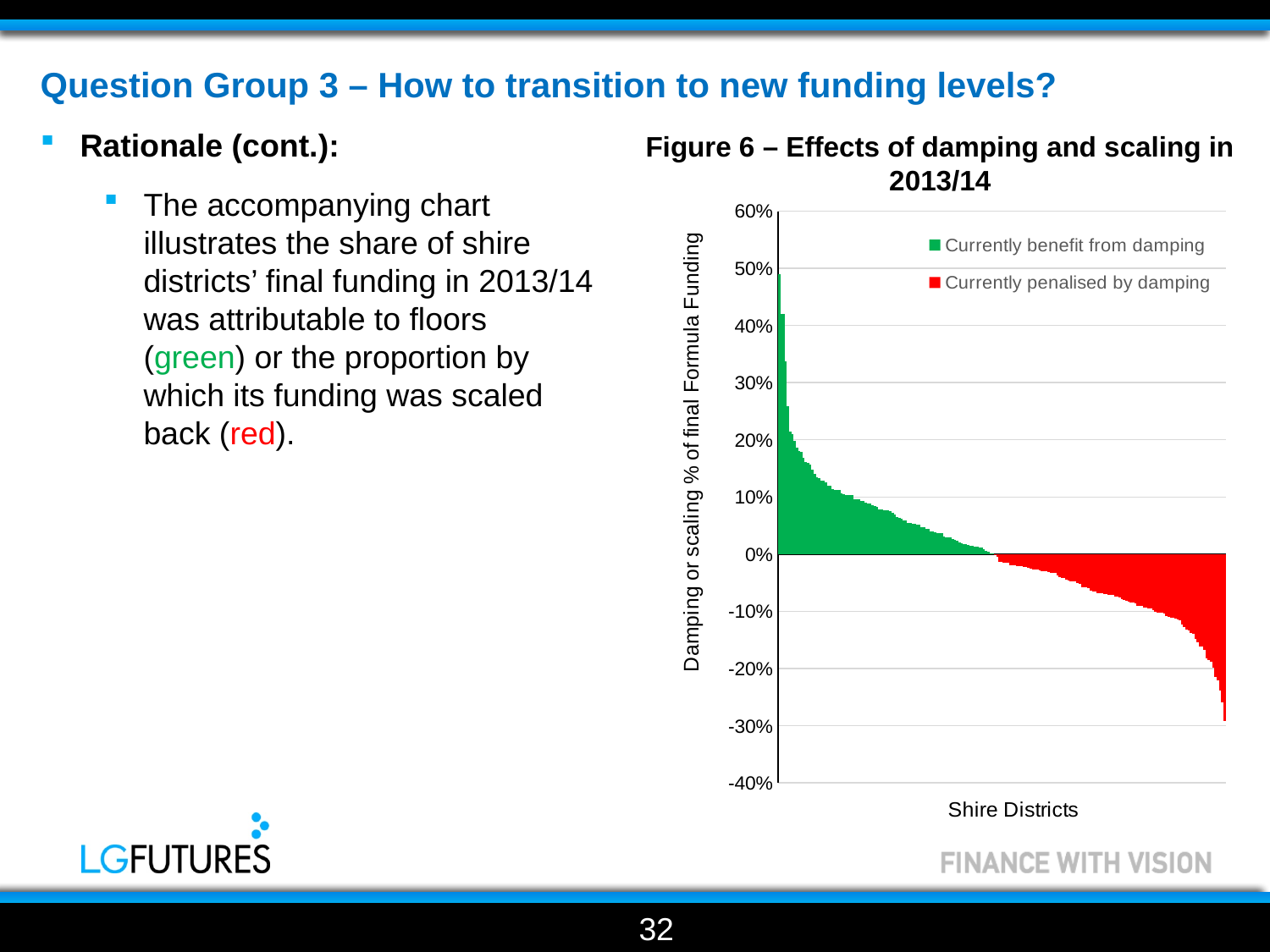
In Figure 6, which series has the bar with the largest absolute value: Currently benefit from damping or Currently penalised by damping? Currently benefit from damping Do the bar values in Figure 6 rise or fall moving from left to right along the x axis? fall In Figure 6, is the value of the lowest red bar greater or less than -40%? greater Which legend entry in Figure 6 is shown in green? Currently benefit from damping What kind of chart is shown in Figure 6? bar chart In Figure 6, is the value of the lowest red bar greater or less than -20%? less What is the title of the chart on the slide? Figure 6 – Effects of damping and scaling in 2013/14 In Figure 6, is the value of the tallest green bar greater or less than 60%? less How many series does the legend of Figure 6 list? 2